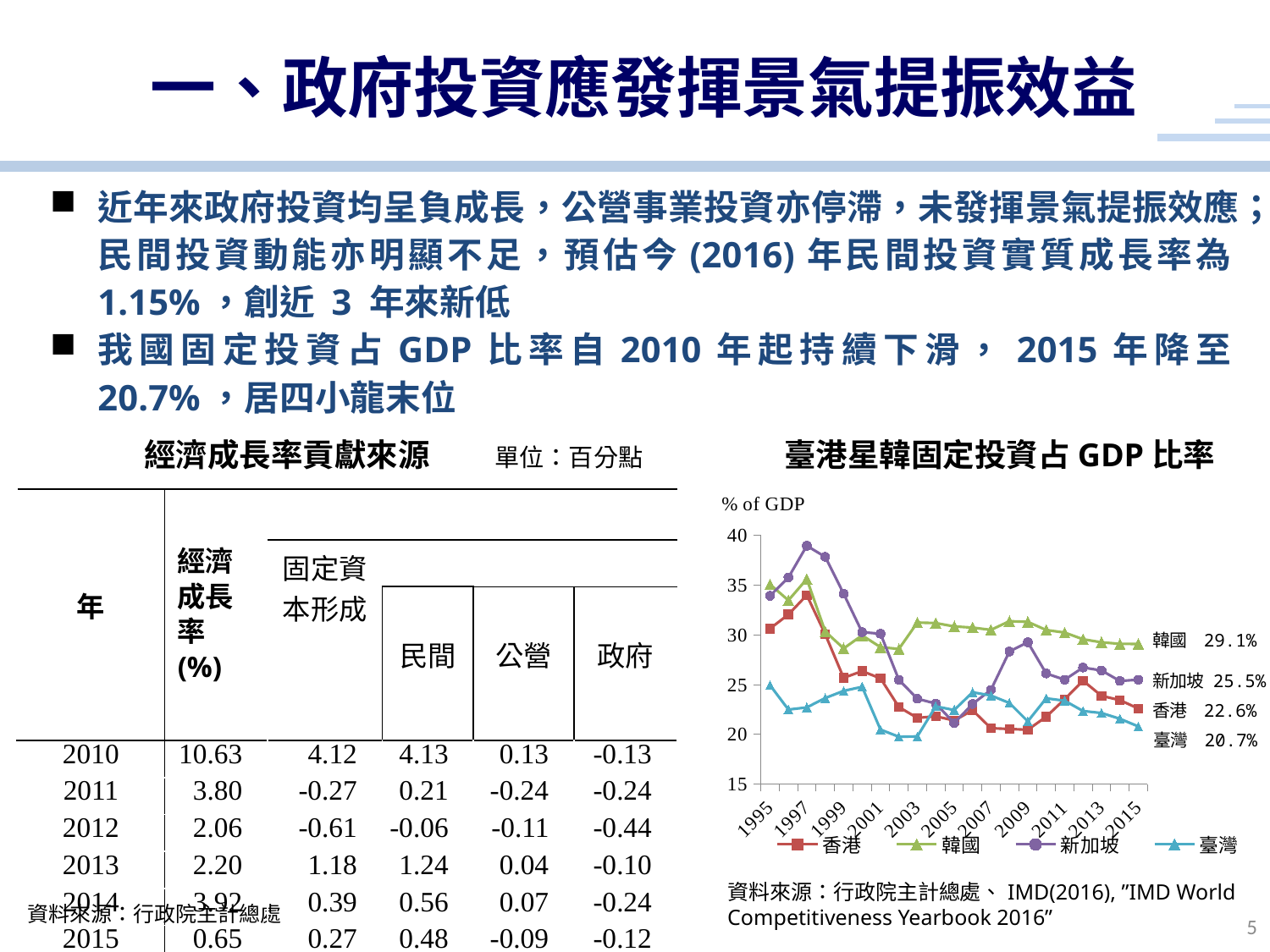
In the chart 臺港星韓固定投資占 GDP 比率, which economy has the highest labelled value at the end of the series? 韓國 In the chart 臺港星韓固定投資占 GDP 比率, what is the value labelled for 香港 at the end of the series? 22.6% In the chart 臺港星韓固定投資占 GDP 比率, which has the larger labelled end value, 新加坡 or 香港? 新加坡 In the chart 臺港星韓固定投資占 GDP 比率, is the value for 新加坡 in 1997 greater or less than 35? greater In the chart 臺港星韓固定投資占 GDP 比率, what unit label is shown above the y axis? % of GDP How many series does the legend of the chart 臺港星韓固定投資占 GDP 比率 list? 4 In the chart 臺港星韓固定投資占 GDP 比率, what is the value labelled for 臺灣 at the end of the series? 20.7% In the chart 臺港星韓固定投資占 GDP 比率, what is the difference between the labelled end values for 韓國 and 臺灣? 8.4 percentage points In the chart 臺港星韓固定投資占 GDP 比率, what is the value labelled for 韓國 at the end of the series? 29.1% In the chart 臺港星韓固定投資占 GDP 比率, which economy has the lowest labelled value at the end of the series? 臺灣 What kind of chart is 臺港星韓固定投資占 GDP 比率? line chart In the chart 臺港星韓固定投資占 GDP 比率, what is the value labelled for 新加坡 at the end of the series? 25.5%